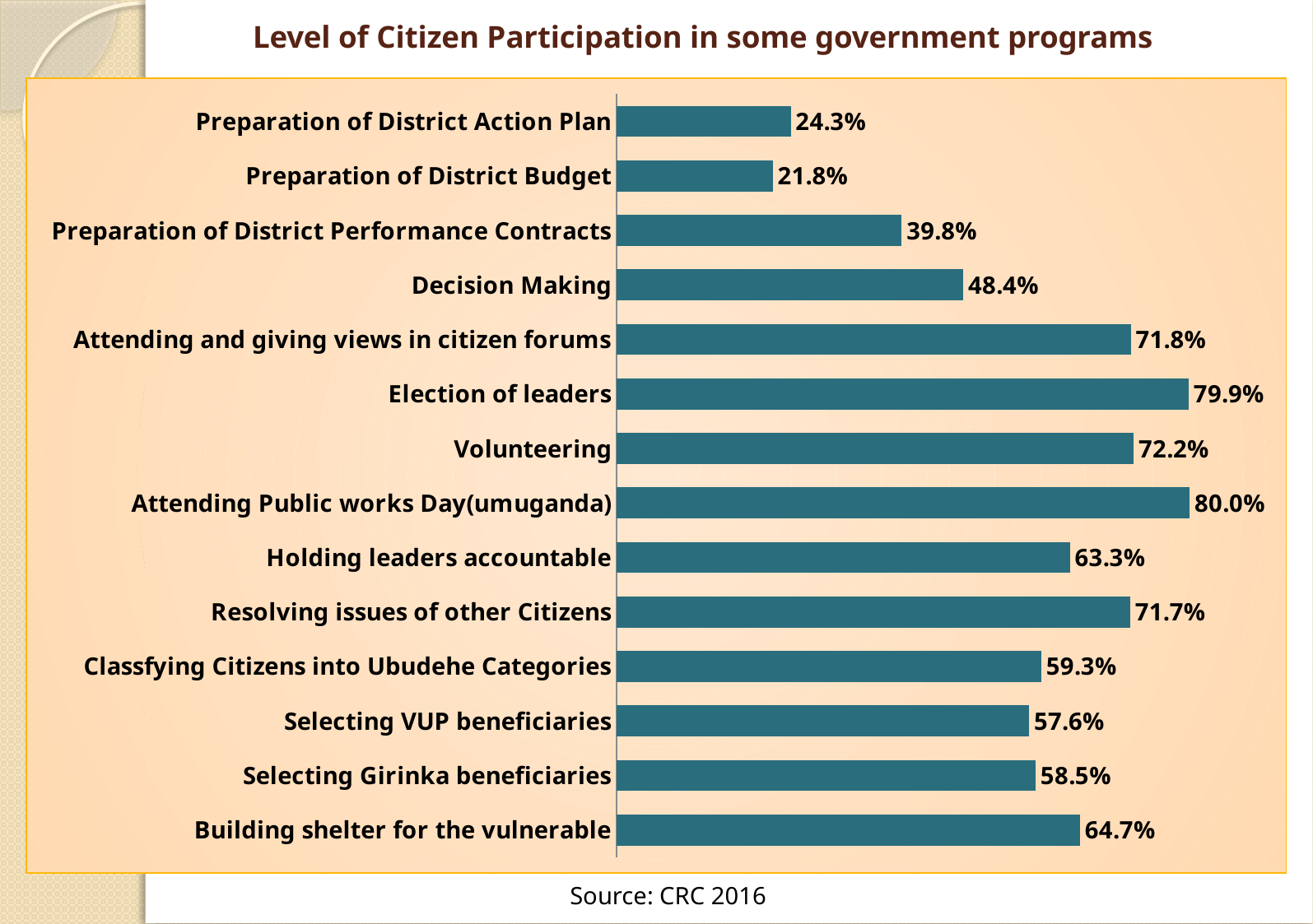
What is the difference between the values for Decision Making and Preparation of District Action Plan? 24.1% What is the value shown for Preparation of District Performance Contracts? 39.8% What is the level of citizen participation in Election of leaders? 79.9% What kind of chart is shown on the slide? Bar chart What is the value shown for Selecting Girinka beneficiaries? 58.5% Which program has the highest level of citizen participation? Attending Public works Day(umuganda) How many programs are shown in the chart? 14 What source is cited below the chart? CRC 2016 Which is larger, the value for Building shelter for the vulnerable or the value for Classfying Citizens into Ubudehe Categories? Building shelter for the vulnerable Which program has the lowest level of citizen participation? Preparation of District Budget What is the value shown for Holding leaders accountable? 63.3% What is the difference between the values for Volunteering and Attending and giving views in citizen forums? 0.4%